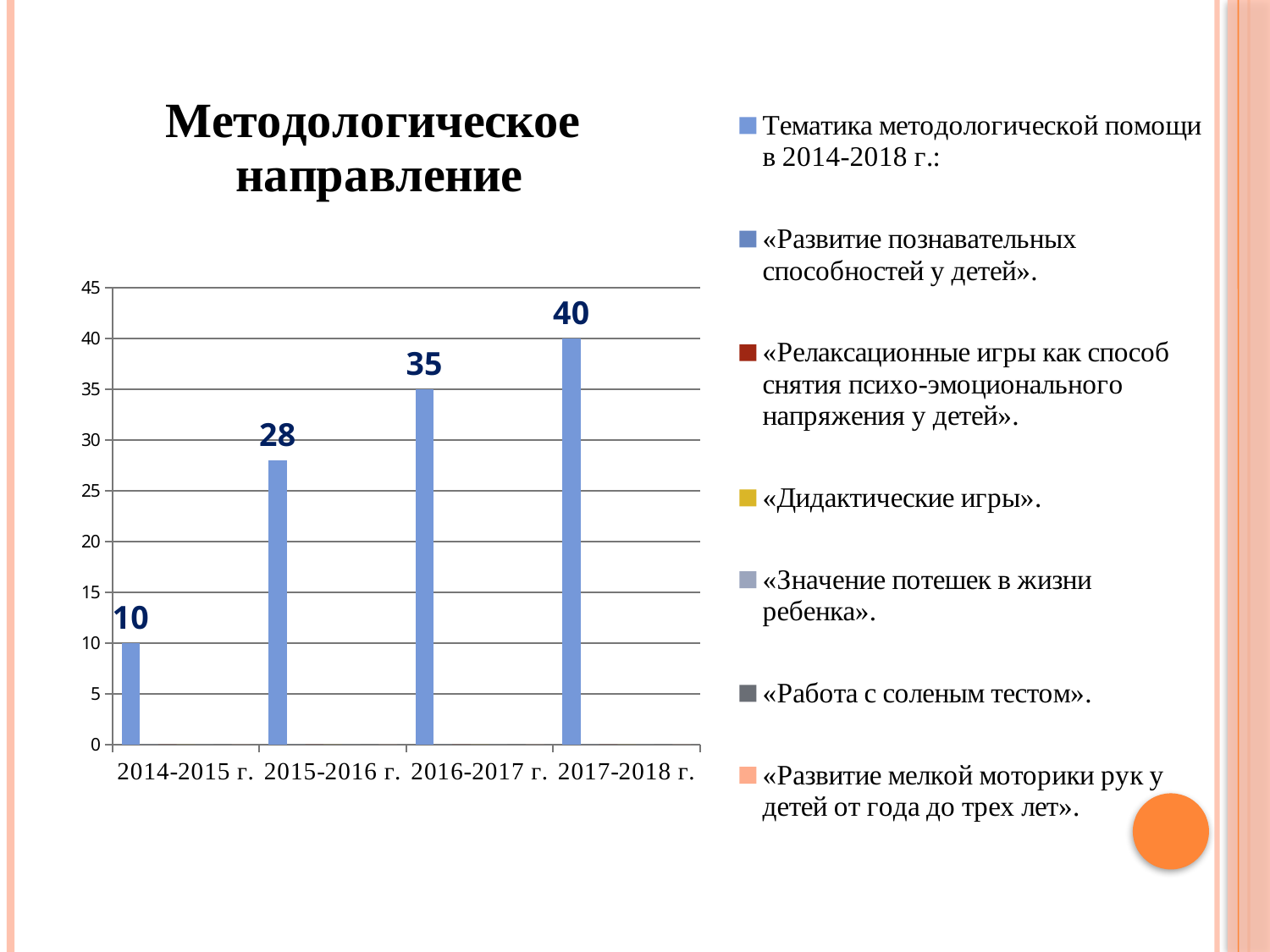
How many categories are shown on the x axis? 4 What is the value for 2014-2015 г.? 10 What is the value for 2017-2018 г.? 40 What is the value for 2016-2017 г.? 35 Which category has the highest value? 2017-2018 г. Which category has the lowest value? 2014-2015 г. Do the values rise or fall from 2014-2015 г. to 2017-2018 г.? Rise Which is larger, the value for 2015-2016 г. or the value for 2016-2017 г.? 2016-2017 г. What is the difference between the values for 2016-2017 г. and 2015-2016 г.? 7 What kind of chart is shown on the slide? Bar chart What is the value for 2015-2016 г.? 28 What is the difference between the values for 2017-2018 г. and 2014-2015 г.? 30